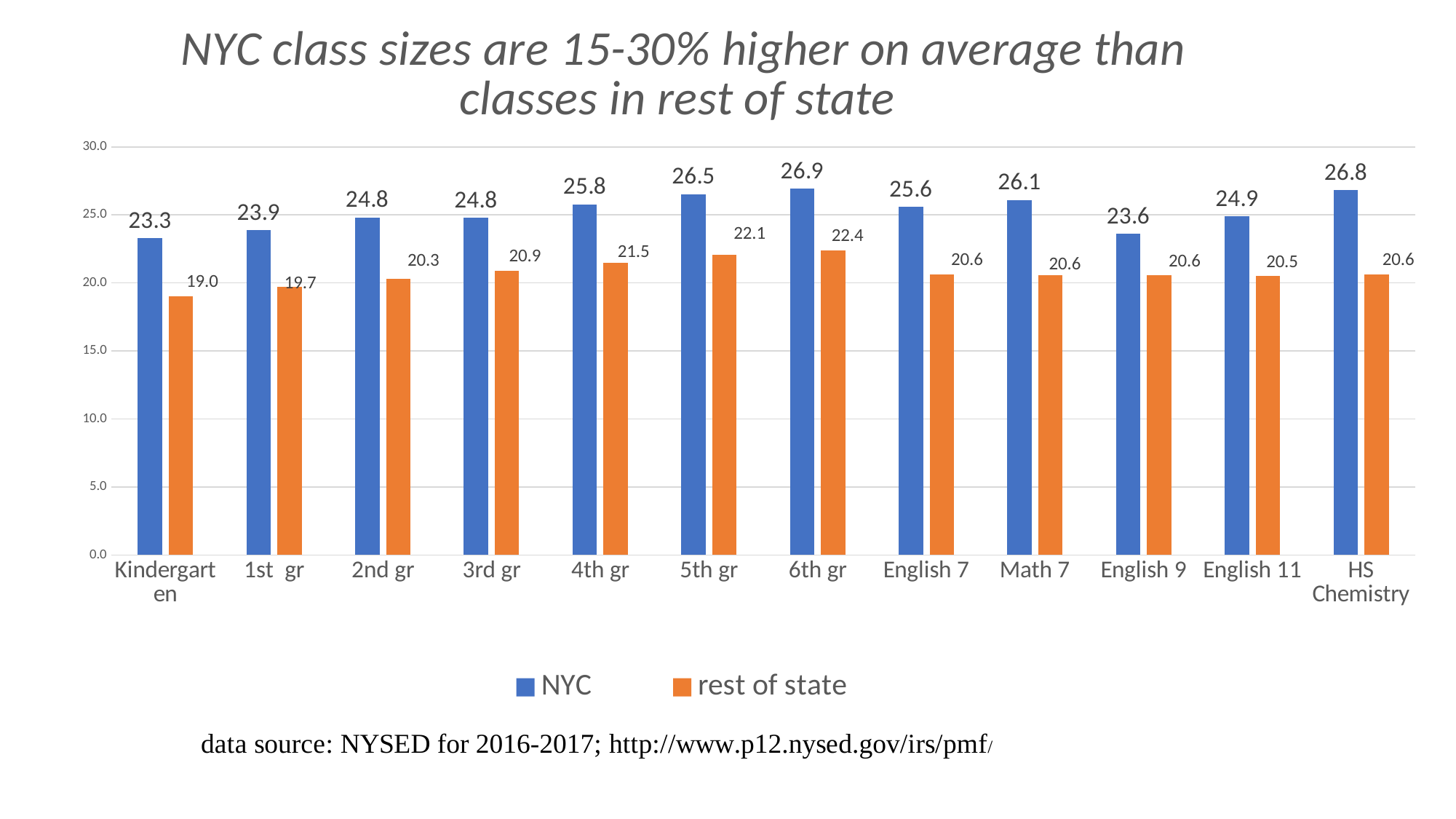
Which colour represents the rest of state series? orange What is the NYC class size for 6th gr? 26.9 What is the rest of state class size for 5th gr? 22.1 Which is larger, the NYC class size for Math 7 or the NYC class size for English 9? Math 7 What is the rest of state class size for Kindergarten? 19.0 Which category has the highest NYC class size? 6th gr How many series does the legend list? 2 What is the title of the chart? NYC class sizes are 15-30% higher on average than classes in rest of state Which category has the lowest rest of state class size? Kindergarten How many categories are shown on the x axis? 12 What kind of chart is shown on the slide? bar chart What is the difference between the NYC and rest of state class sizes for HS Chemistry? 6.2